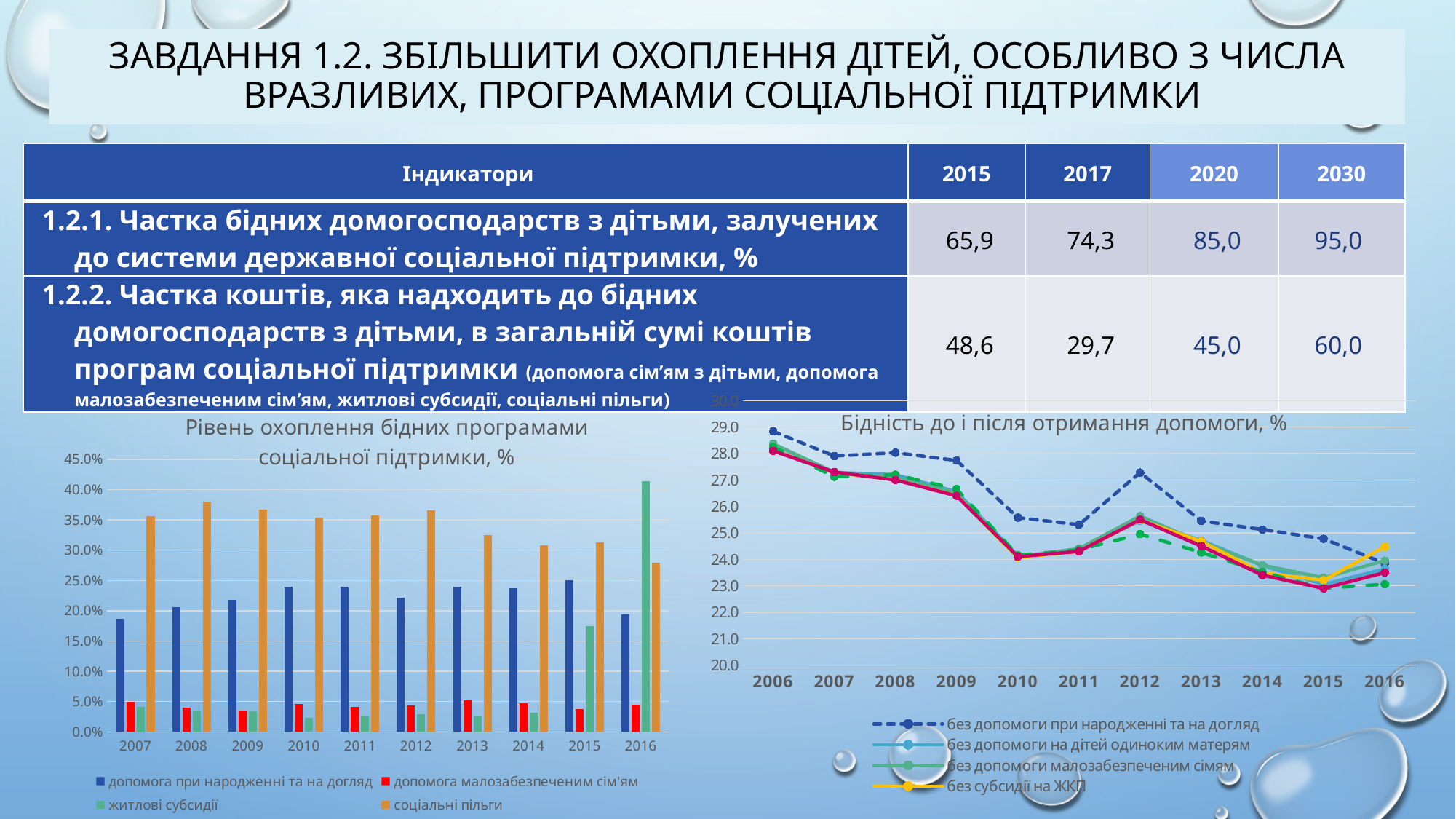
In the right line chart, how many years are shown on the x axis? 11 In the right line chart, how many series does the legend list? 4 In the left bar chart, is the value for "соціальні пільги" in 2008 greater or less than 35.0%? greater In the left bar chart, which is larger in 2016: "житлові субсидії" or "соціальні пільги"? житлові субсидії In the left bar chart, is the value for "допомога при народженні та на догляд" in 2007 greater or less than 20.0%? less In the right line chart, does the series "без допомоги при народженні та на догляд" rise or fall overall from 2006 to 2016? fall In the left bar chart, in which year is the value for "житлові субсидії" highest? 2016 In the left bar chart, how many years are shown on the x axis? 10 In the left bar chart, how many series does the legend list? 4 In the right line chart, is the value for "без допомоги при народженні та на догляд" in 2006 greater or less than 28.0? greater What kind of chart is the left chart titled "Рівень охоплення бідних програмами соціальної підтримки, %"? bar chart What kind of chart is the right chart titled "Бідність до і після отримання допомоги, %"? line chart